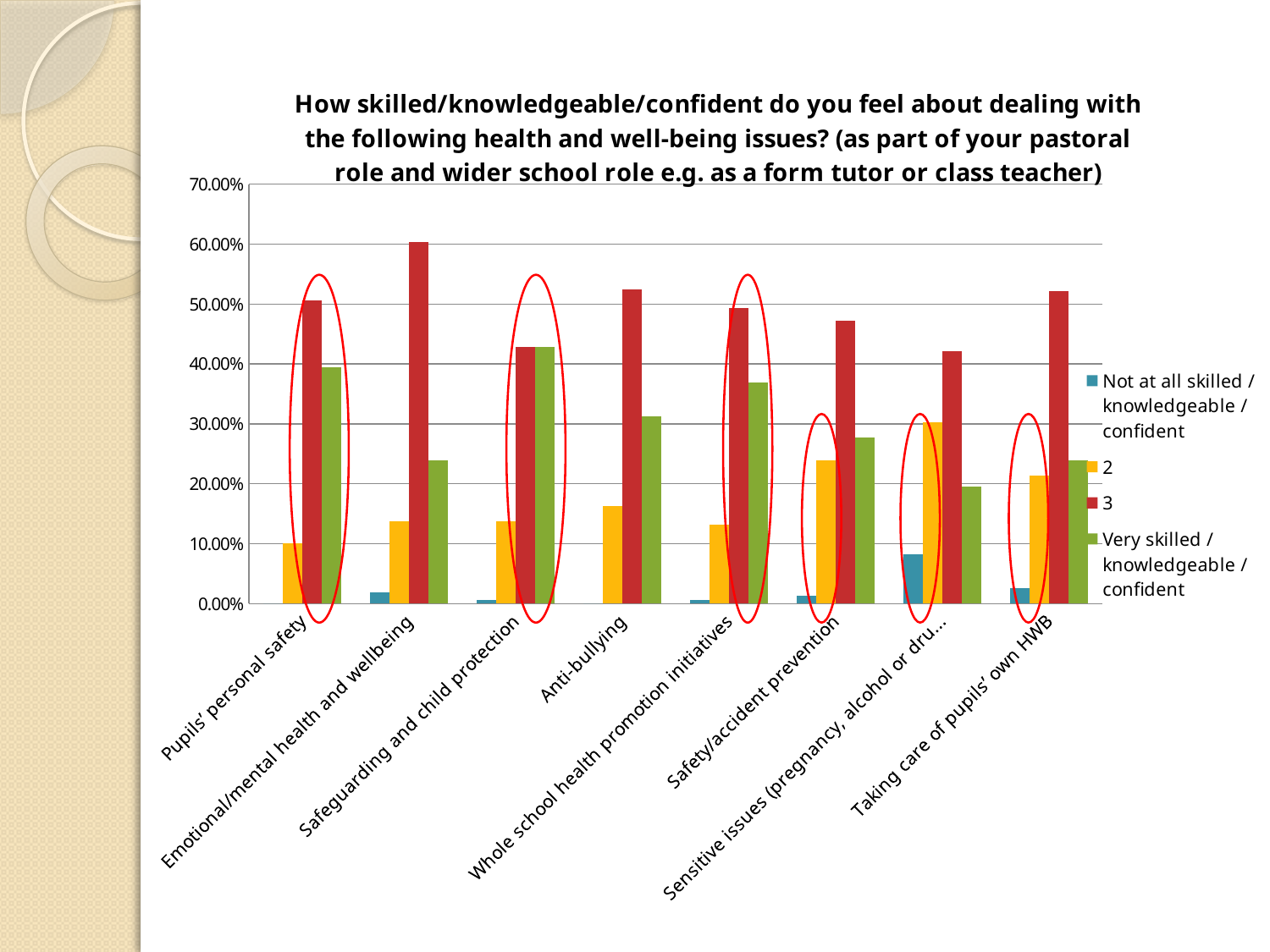
Which category has the highest value for the "Very skilled / knowledgeable / confident" series? Safeguarding and child protection How many series does the chart's legend list? 4 What kind of chart is shown on the slide? Bar chart Which category has the highest value for the series "2"? Sensitive issues (pregnancy, alcohol or dru... Which category has the highest value for the series "3"? Emotional/mental health and wellbeing Is the "Very skilled / knowledgeable / confident" value for Pupils' personal safety greater or less than 30.00%? greater How many categories are shown along the x axis of the chart? 8 Is the value of series "2" for Sensitive issues (pregnancy, alcohol or dru...) greater or less than 20.00%? greater For the series "2", which is larger: Safety/accident prevention or Anti-bullying? Safety/accident prevention What colour represents the series "3" in the chart? Red Is the value of series "3" for Emotional/mental health and wellbeing greater or less than 50.00%? greater